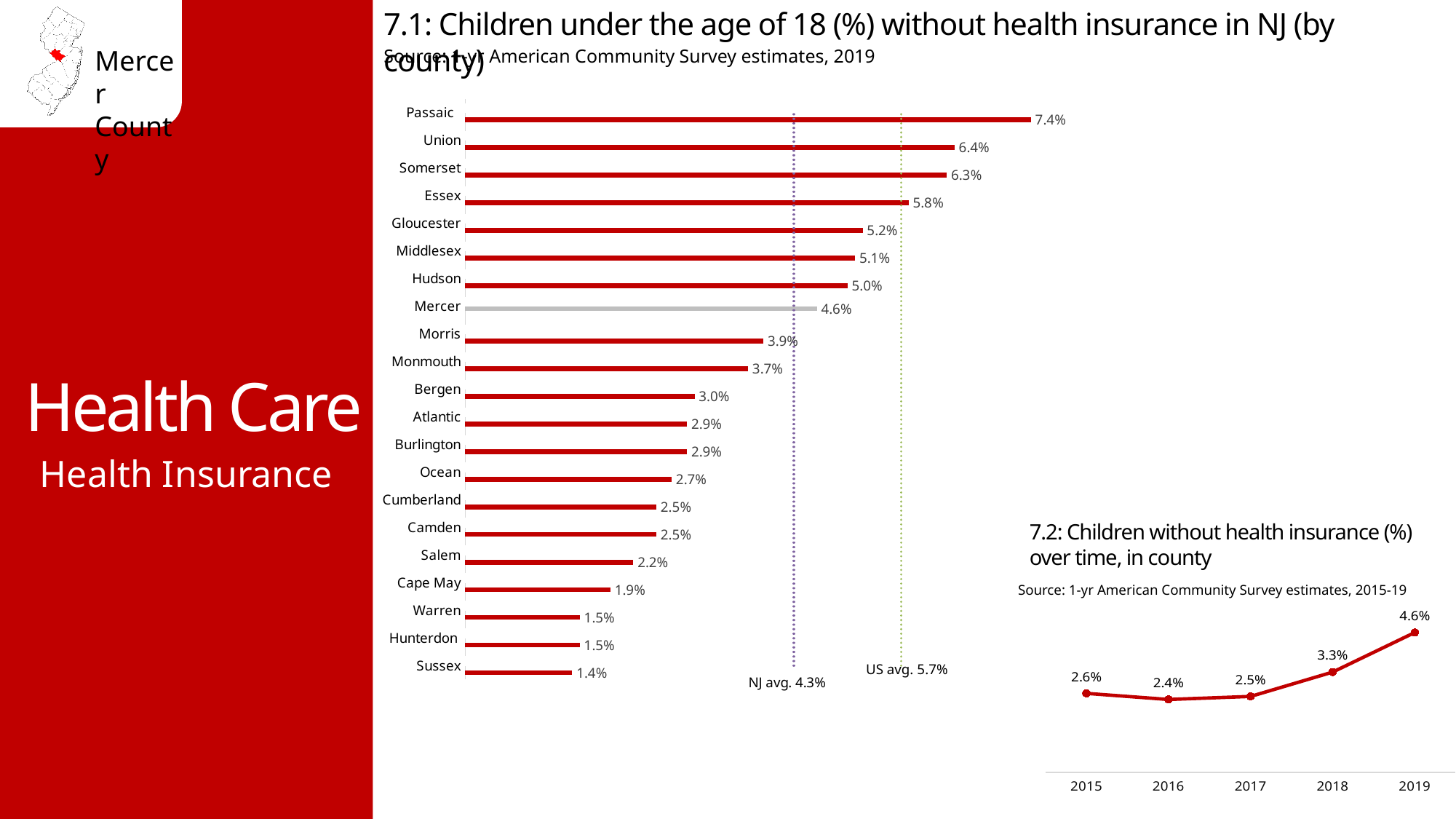
In chart 7.1, which county has the highest percentage of children without health insurance? Passaic In chart 7.1, which county has the lowest percentage of children without health insurance? Sussex In chart 7.2, what is the difference between the 2019 and 2015 values? 2.0% In chart 7.1, which has a higher value, Union or Essex? Union In chart 7.1, what is the difference between the values for Passaic and Sussex? 6.0% What kind of chart is chart 7.1? Bar chart What kind of chart is chart 7.2? Line chart In chart 7.2, which year has the lowest value? 2016 In chart 7.1, how many counties are shown? 21 In chart 7.1 (children under 18 without health insurance by county), what is the value for Mercer? 4.6% In chart 7.2 (children without health insurance over time), what is the value for 2018? 3.3% In chart 7.1, what is the NJ average shown by the dotted reference line? 4.3%